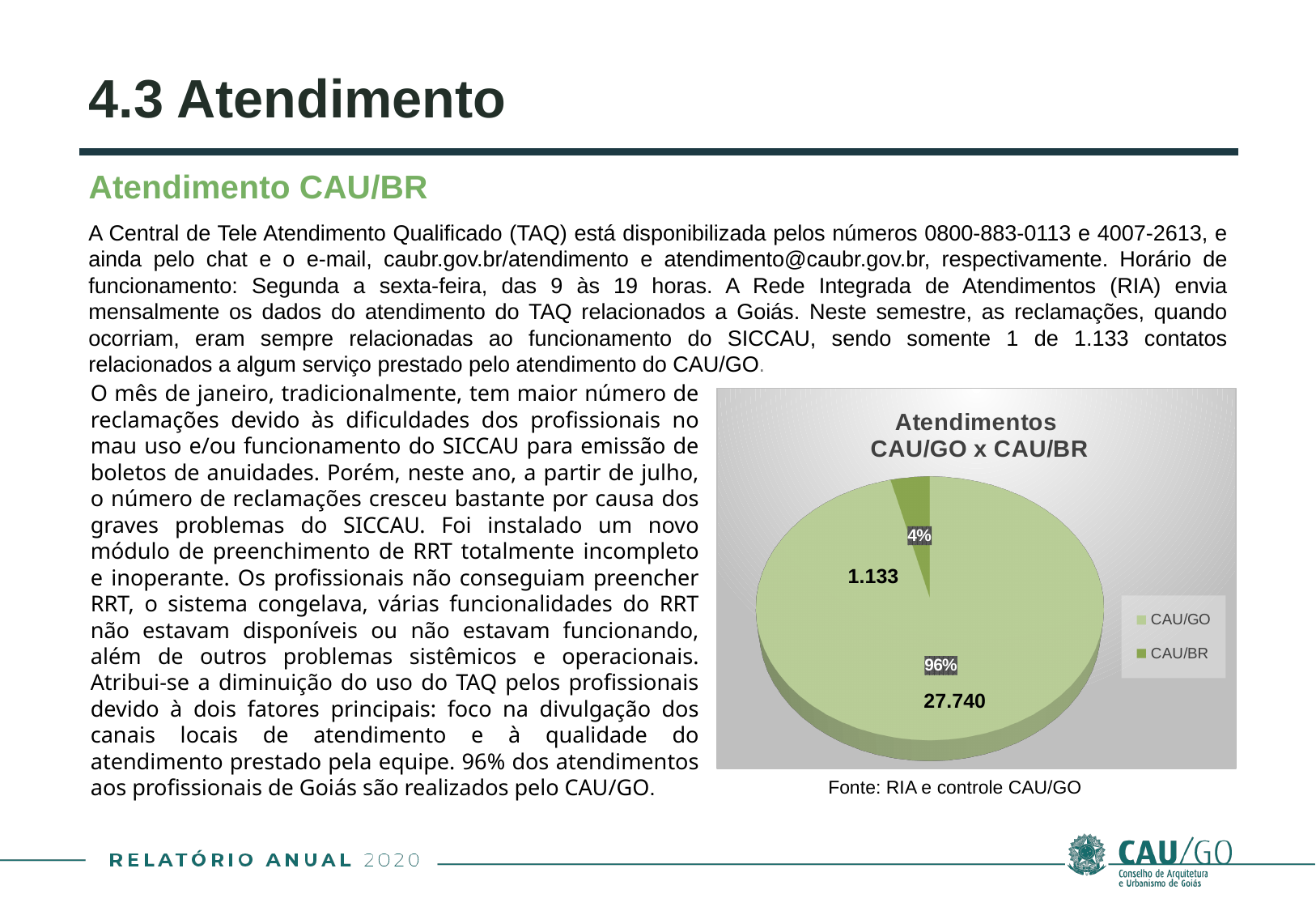
What is the value shown for CAU/BR in the pie chart? 1.133 Which category has the largest slice in the pie chart? CAU/GO What share of the pie does CAU/BR represent? 4% How many entries does the chart legend list? 2 What is the title of the chart? Atendimentos CAU/GO x CAU/BR Which category has the smallest slice in the pie chart? CAU/BR What is the value shown for CAU/GO in the pie chart? 27.740 What share of the pie does CAU/GO represent? 96% What is the difference between the CAU/GO value and the CAU/BR value? 26.607 How many slices does the pie chart have? 2 What kind of chart is shown on the slide? Pie chart Which is larger, the value for CAU/GO or the value for CAU/BR? CAU/GO